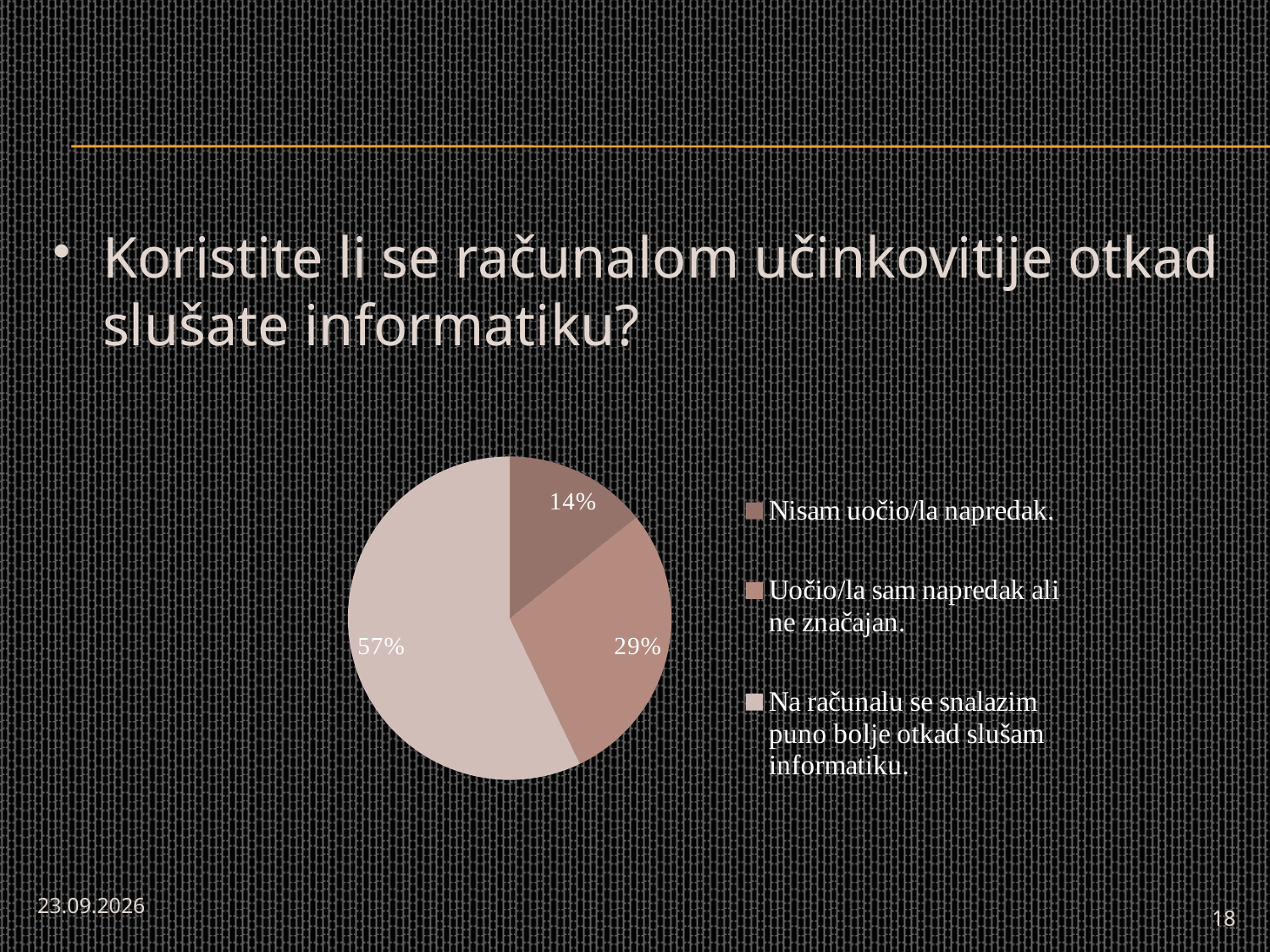
What question does the slide title ask above the pie chart? Koristite li se računalom učinkovitije otkad slušate informatiku? Which category has the largest slice of the pie? Na računalu se snalazim puno bolje otkad slušam informatiku. How many entries does the legend of the pie chart list? 3 Which category has the smallest slice of the pie? Nisam uočio/la napredak. What share of the pie is labelled "Uočio/la sam napredak ali ne značajan."? 29% What kind of chart is shown on the slide? pie chart How many slices does the pie chart have? 3 What is the difference in percentage points between the 29% slice and the 14% slice? 15 What is the difference in percentage points between the largest slice (57%) and the smallest slice (14%)? 43 Which is larger: the slice for "Uočio/la sam napredak ali ne značajan." or the slice for "Nisam uočio/la napredak."? Uočio/la sam napredak ali ne značajan. What share of the pie is labelled "Na računalu se snalazim puno bolje otkad slušam informatiku."? 57% What share of the pie is labelled "Nisam uočio/la napredak."? 14%